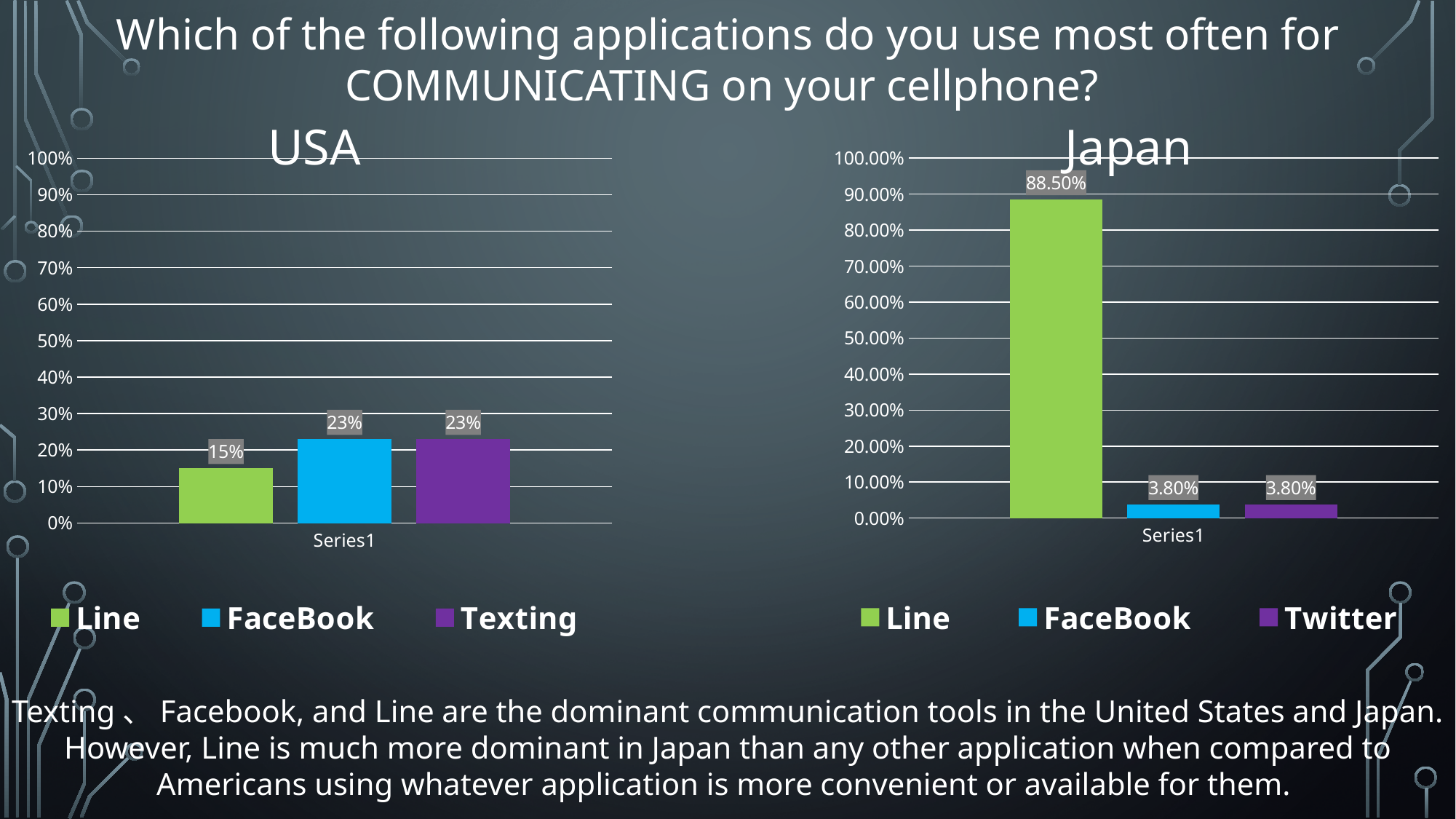
In the Japan chart, is the value for Line greater or less than 80.00%? greater In the Japan chart, which application has the highest value? Line In the USA chart, what is the difference between the FaceBook value and the Line value? 8% In the Japan chart, what is the value for Twitter? 3.80% In the USA chart, which application has the lowest value? Line In the USA chart, what is the value for Line? 15% In the Japan chart, what is the value for Line? 88.50% What kind of chart is the USA chart? Bar chart In the USA chart, what is the value for FaceBook? 23% In the Japan chart, what is the difference between the Line value and the FaceBook value? 84.70% How many series does the legend of the Japan chart list? 3 In the Japan chart, which legend entry replaces Texting from the USA chart? Twitter